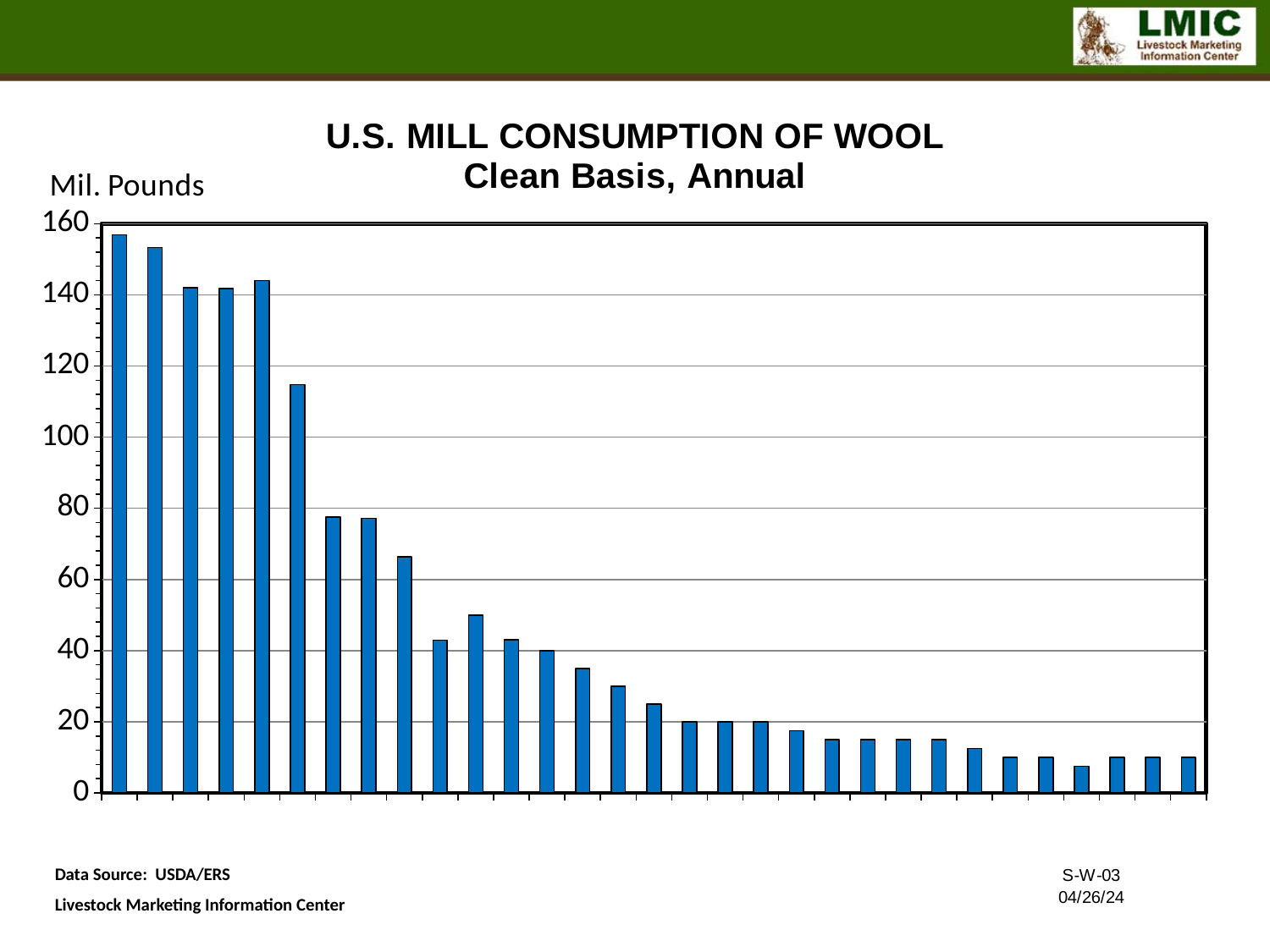
Is the value of the sixth bar from the left greater or less than 100? greater Do the values generally rise or fall from left to right across the chart? fall Is the value of the leftmost bar greater or less than 140? greater Is the value of the seventh bar from the left greater or less than 80? less What is the title of the chart? U.S. MILL CONSUMPTION OF WOOL Clean Basis, Annual Which bar is the tallest in the chart? the leftmost bar What unit is shown on the vertical axis of the chart? Mil. Pounds What kind of chart is shown on the slide? bar chart How many bars are plotted in the chart? 31 Which is larger, the leftmost bar or the rightmost bar? the leftmost bar